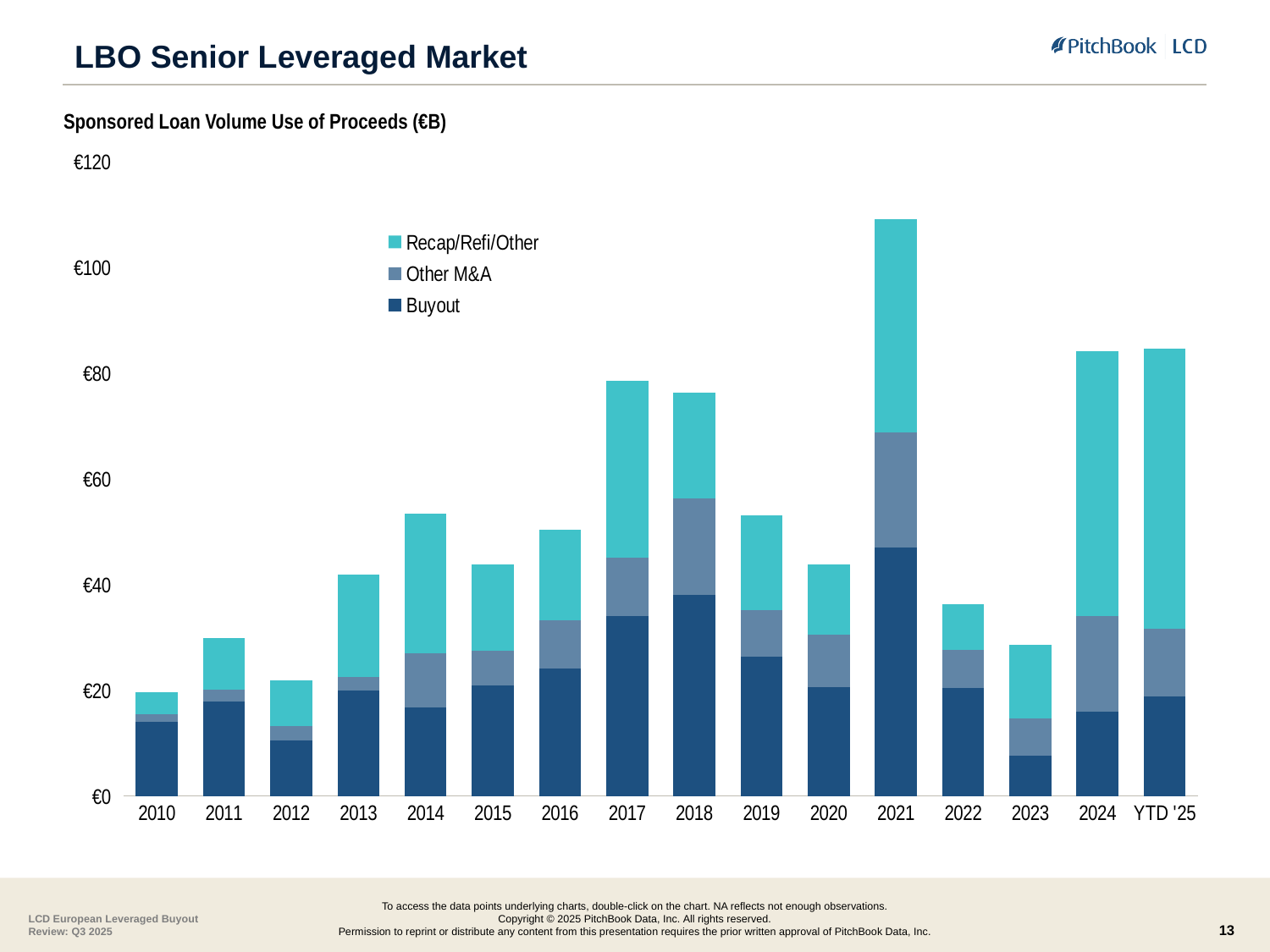
Is the total bar for 2010 greater or less than €40? less How many series does the legend list? 3 Which period has the smallest Buyout segment? 2023 Which has the larger total bar, 2014 or 2015? 2014 Is the total bar for 2021 greater or less than €100? greater What kind of chart is shown on the slide? Stacked bar chart Which period has the highest total sponsored loan volume? 2021 Is the total bar for 2024 greater or less than €80? greater Which series is shown in the darkest blue at the bottom of each bar? Buyout Do the total bars rise or fall from 2010 to 2014? rise How many periods are shown along the x axis? 16